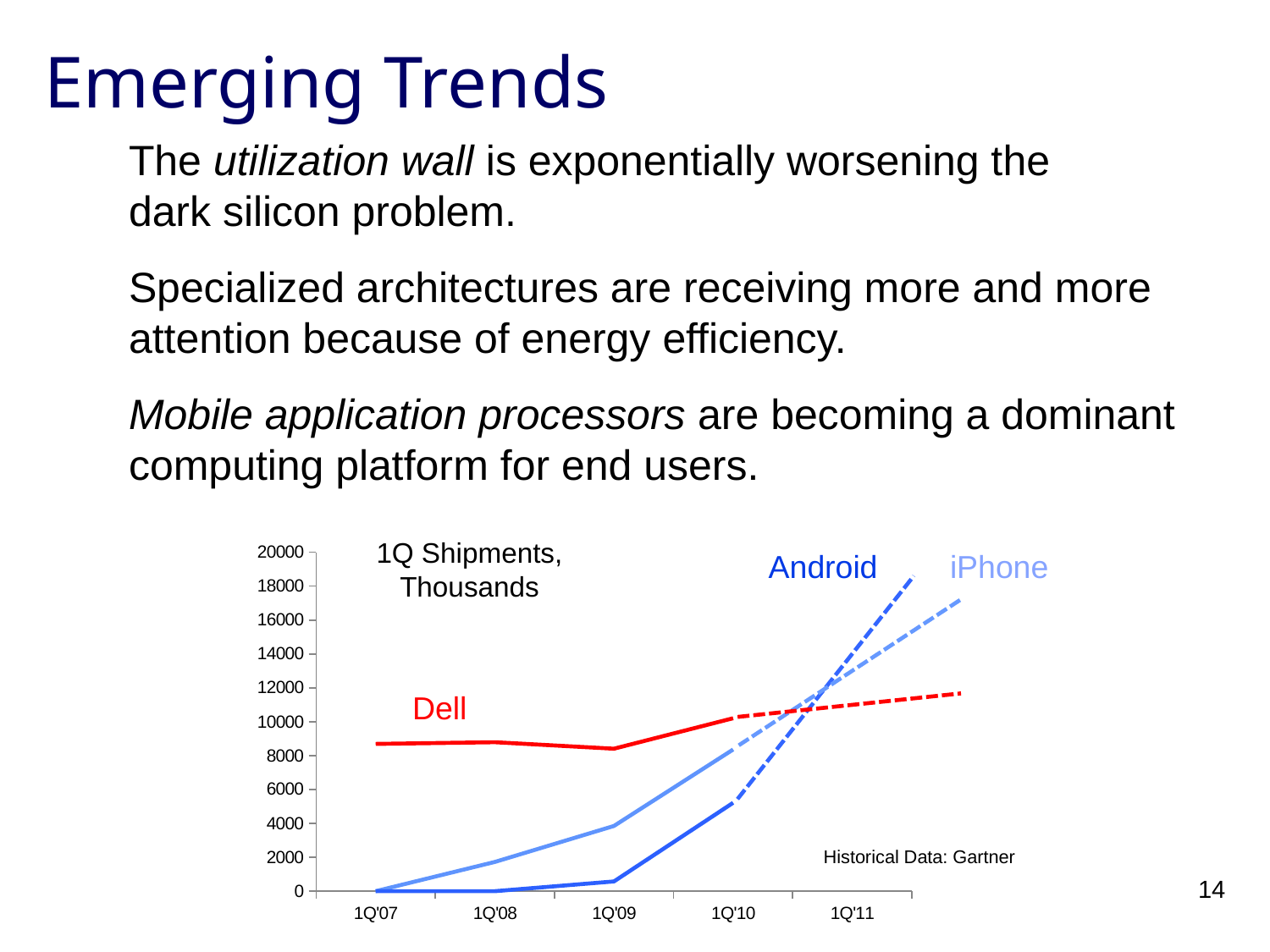
Which series has the lowest value at 1Q'08? Android What kind of chart is shown on the slide? Line chart How many quarters are labelled on the x axis of the chart? 5 What is the title of the chart? 1Q Shipments, Thousands Which series has the highest value at the right end of the chart (1Q'11)? Android Is the value for iPhone at 1Q'09 greater or less than 6000? less Is the value for Dell at 1Q'07 greater or less than 8000? greater Is the value for Android at 1Q'10 greater or less than 4000? greater How many series are plotted in the chart? 3 Which series has the highest value at 1Q'09? Dell Do the iPhone values rise or fall from 1Q'07 to 1Q'11? rise At 1Q'10, which is larger, the value for Dell or the value for iPhone? Dell